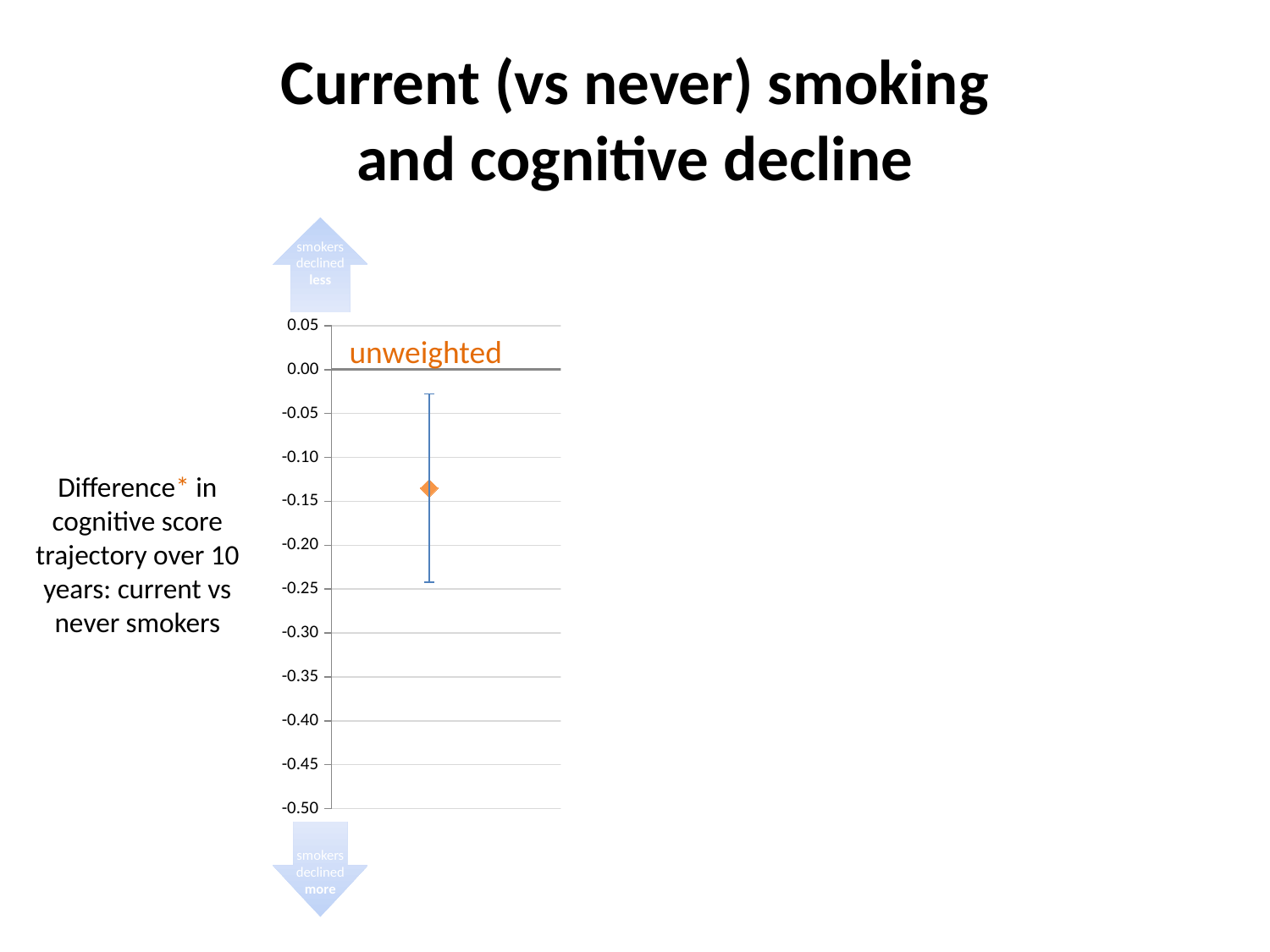
What kind of chart is shown on the slide? A point estimate with error bars (scatter plot) Is the lower end of the error bar for the unweighted estimate greater or less than -0.30? greater Is the plotted value for the unweighted estimate greater or less than 0.00? less Is the plotted value for the unweighted estimate greater or less than -0.10? less How many data points are plotted on the chart? 1 What is the label shown next to the plotted estimate on the chart? unweighted What is the highest value shown on the vertical axis of the chart? 0.05 What is the lowest value shown on the vertical axis of the chart? -0.50